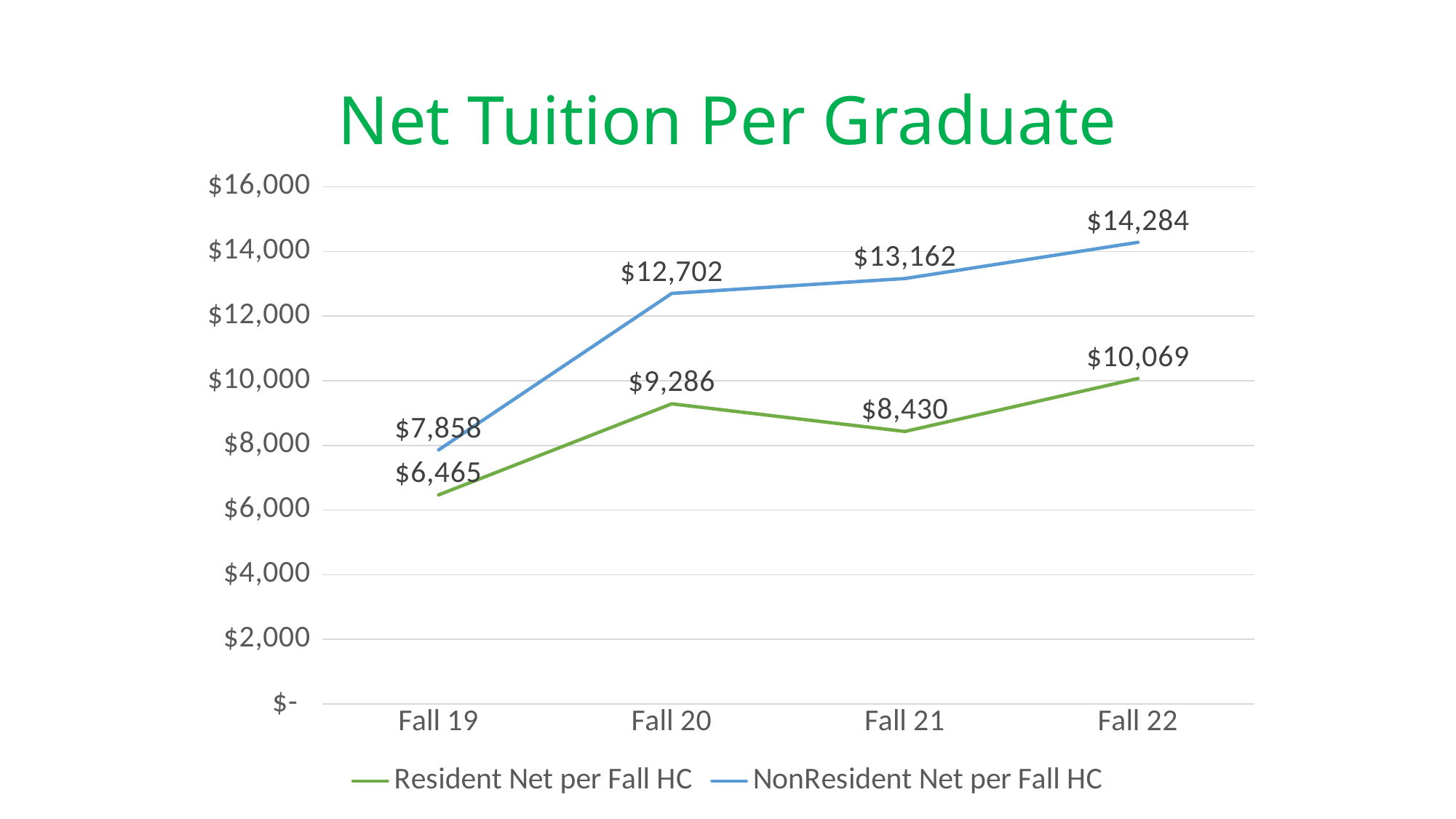
Which is larger, the Resident Net per Fall HC value in Fall 20 or in Fall 21? Fall 20 What is the difference between the NonResident and Resident Net per Fall HC values in Fall 21? $4,732 What is the Resident Net per Fall HC value for Fall 19? $6,465 What is the NonResident Net per Fall HC value for Fall 22? $14,284 Does the NonResident Net per Fall HC series rise or fall from Fall 19 to Fall 22? rise What is the NonResident Net per Fall HC value for Fall 20? $12,702 How many series does the legend list? 2 What kind of chart is shown on the slide? line chart In which term is the Resident Net per Fall HC value highest? Fall 22 How many terms are shown on the x axis? 4 Is the Resident Net per Fall HC value for Fall 22 greater or less than $10,000? greater In which term is the NonResident Net per Fall HC value lowest? Fall 19